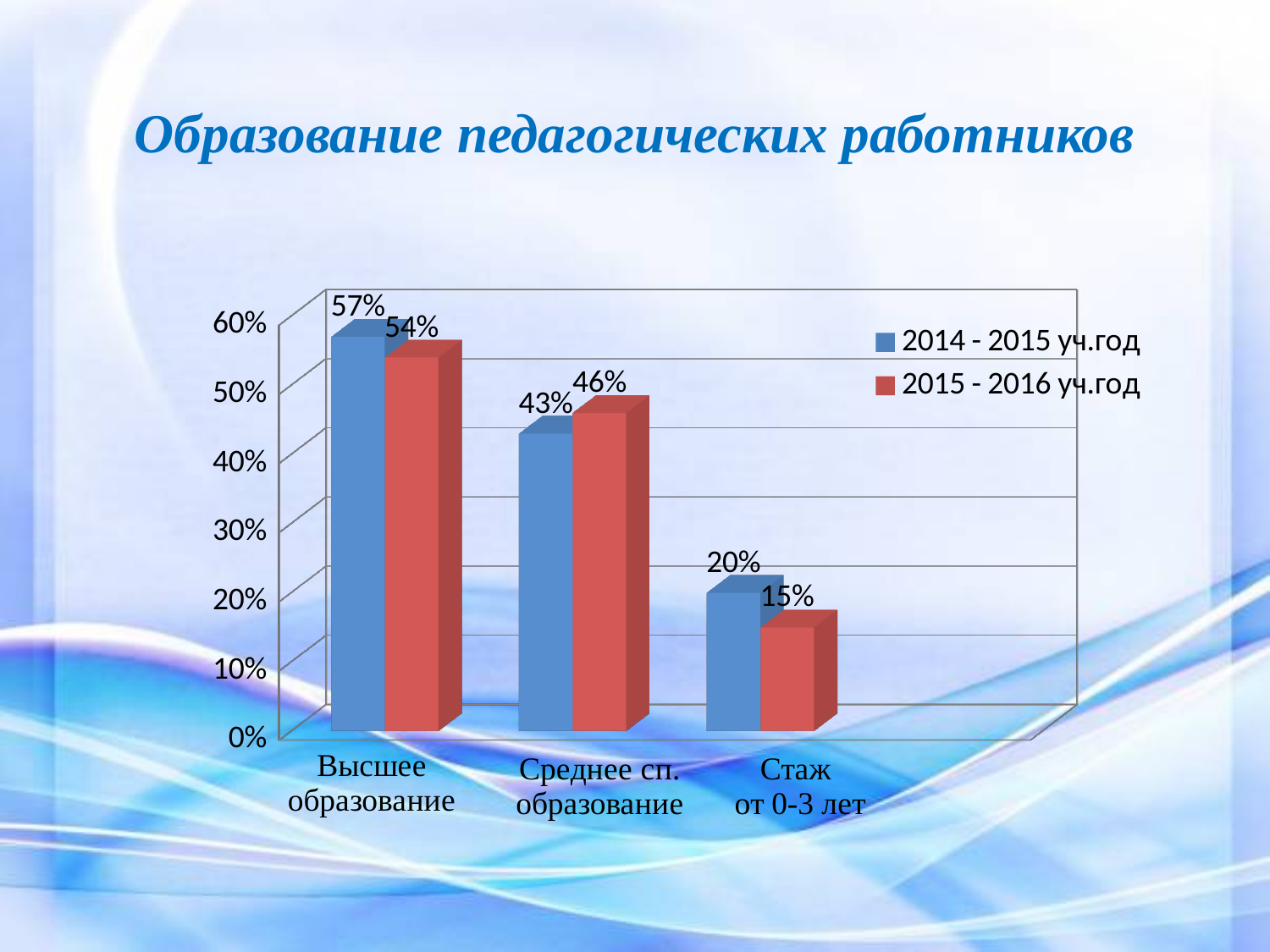
Which category has the lowest value in the 2015 - 2016 уч.год series? Стаж от 0-3 лет How many categories are shown on the x axis? 3 What is the value for Высшее образование in the 2014 - 2015 уч.год series? 57% Is the 2015 - 2016 уч.год value for Высшее образование greater or less than 50%? greater How many series does the legend list? 2 Which category has the highest value in the 2014 - 2015 уч.год series? Высшее образование What is the value for Стаж от 0-3 лет in the 2015 - 2016 уч.год series? 15% What kind of chart is shown on the slide? bar chart What is the difference between the 2014 - 2015 уч.год and 2015 - 2016 уч.год values for Стаж от 0-3 лет? 5% Which is larger for Среднее сп. образование: the 2014 - 2015 уч.год value or the 2015 - 2016 уч.год value? 2015 - 2016 уч.год What is the value for Среднее сп. образование in the 2015 - 2016 уч.год series? 46% What is the title of the slide? Образование педагогических работников